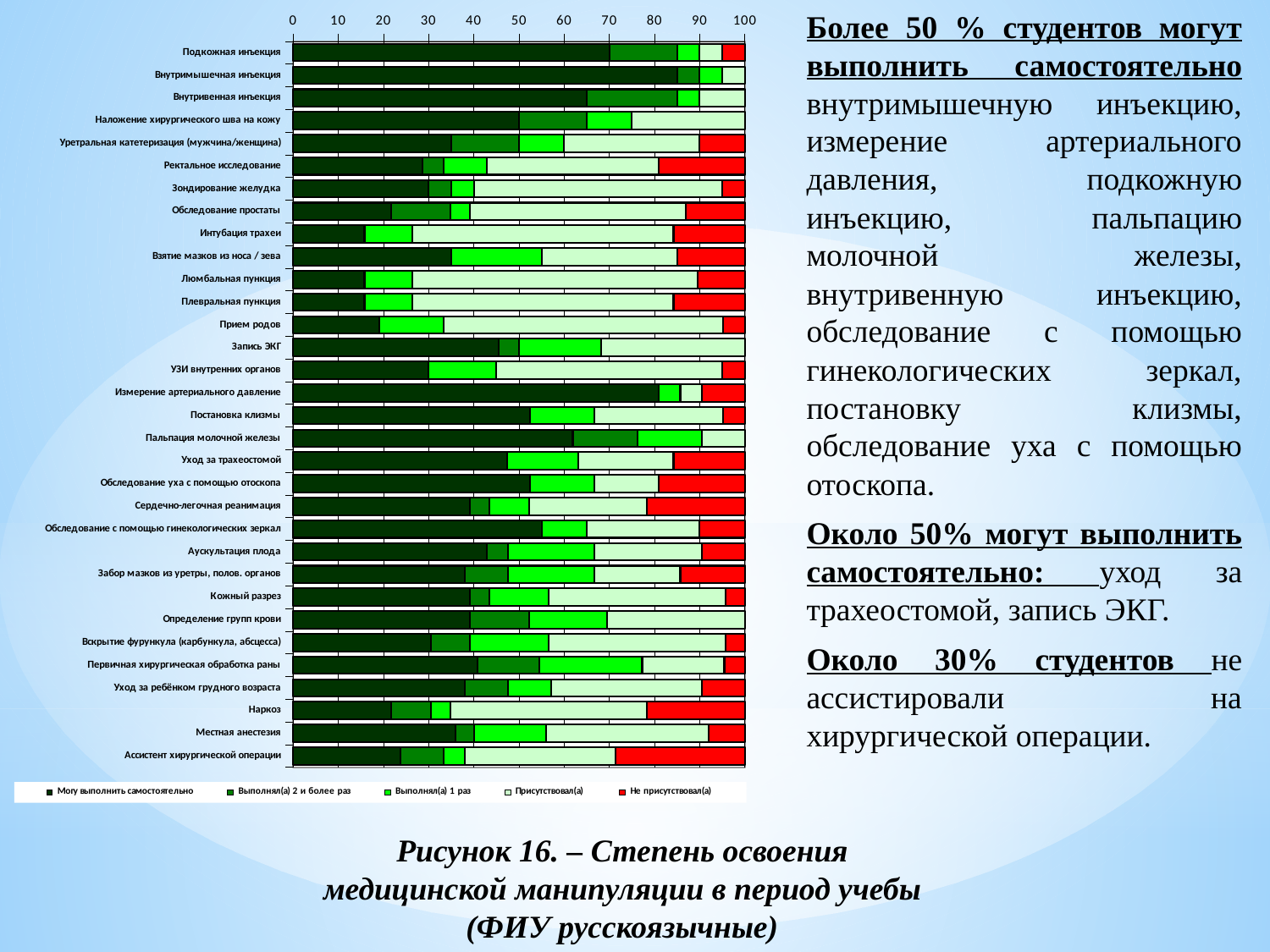
Is the 'Могу выполнить самостоятельно' value for 'Ассистент хирургической операции' greater or less than 30? less Is the 'Могу выполнить самостоятельно' value for 'Измерение артериального давление' greater or less than 70? greater What is the maximum value shown on the chart's horizontal axis? 100 How many series does the chart legend list? 5 Is the 'Могу выполнить самостоятельно' value for 'Люмбальная пункция' greater or less than 20? less Which has the larger 'Могу выполнить самостоятельно' segment: 'Подкожная инъекция' or 'Наркоз'? Подкожная инъекция What kind of chart is shown on the slide? Stacked bar chart Which has the larger 'Могу выполнить самостоятельно' segment: 'Измерение артериального давление' or 'Интубация трахеи'? Измерение артериального давление How many medical manipulations (categories) are plotted on the chart? 32 Which legend entry is shown in red? Не присутствовал(а)